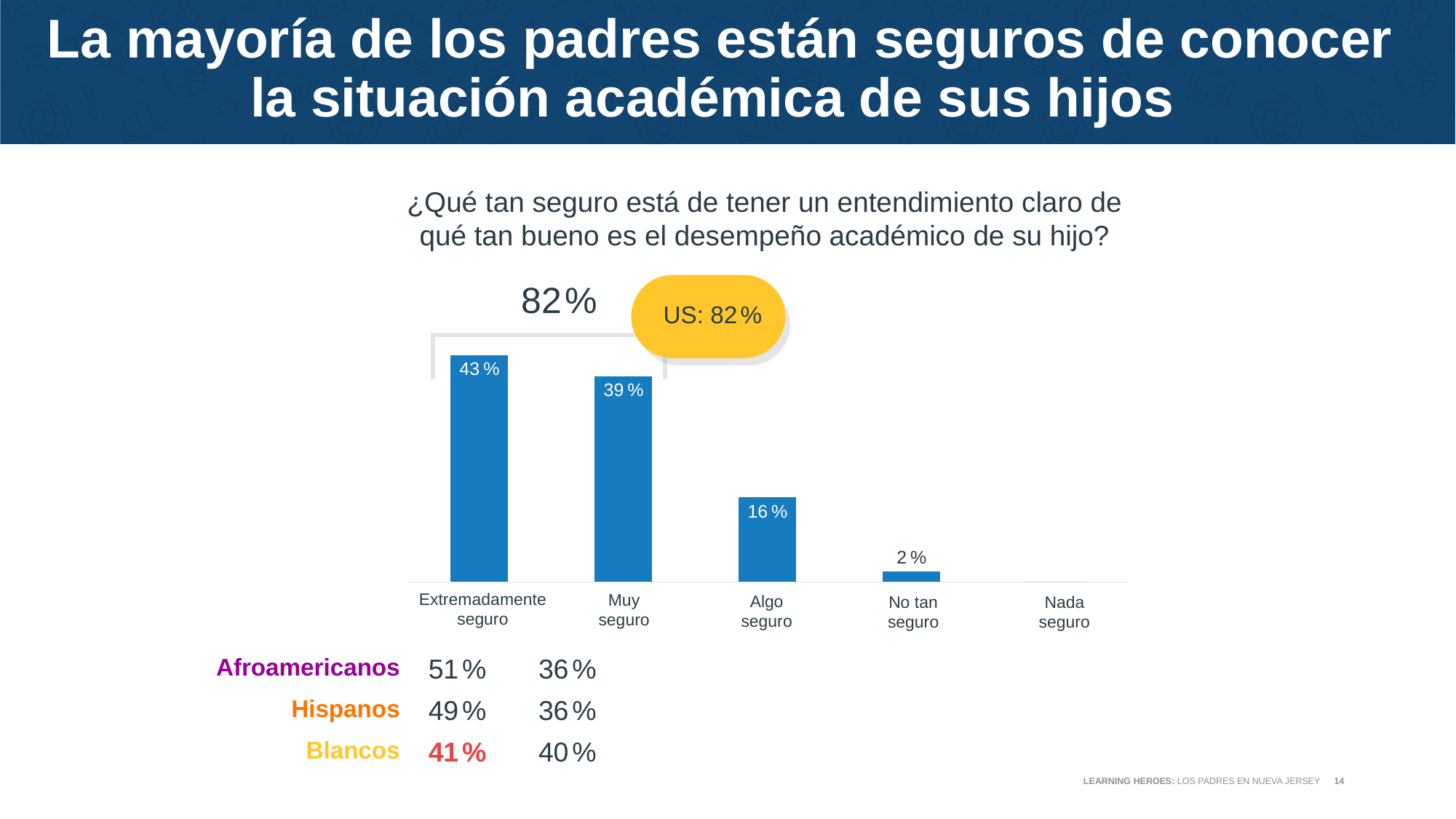
What is the value for "Muy seguro"? 39% What is the value for "No tan seguro"? 2% How many categories are shown on the x axis? 5 What kind of chart is shown on the slide? Bar chart What is the value for "Algo seguro"? 16% What combined percentage is shown by the bracket over the first two bars? 82% Which is larger, the value for "Algo seguro" or the value for "No tan seguro"? Algo seguro What is the value for "Extremadamente seguro"? 43% What is the difference between the values for "Extremadamente seguro" and "Muy seguro"? 4% Which category with a labelled bar has the lowest value? No tan seguro Which category has the highest value? Extremadamente seguro What is the difference between the values for "Muy seguro" and "Algo seguro"? 23%